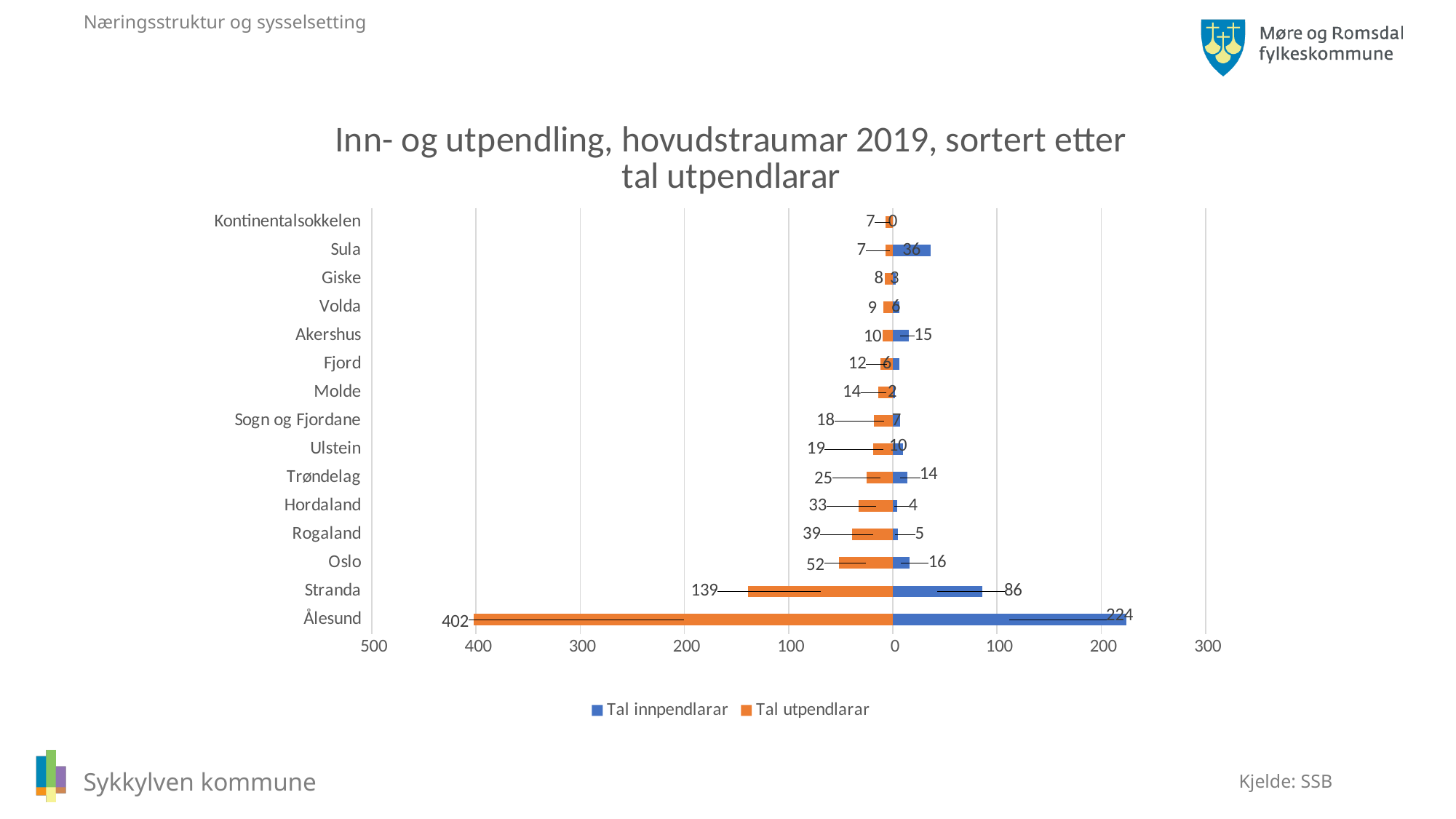
What is the value of Tal utpendlarar for Oslo? 52 What is the value of Tal innpendlarar for Sula? 36 Which category has the highest value of Tal utpendlarar? Ålesund What is the difference between Tal utpendlarar and Tal innpendlarar for Ålesund? 178 How many categories are shown on the vertical axis? 15 How many series does the legend list? 2 What is the title of the chart? Inn- og utpendling, hovudstraumar 2019, sortert etter tal utpendlarar Which category has the lowest value of Tal innpendlarar? Kontinentalsokkelen What is the value of Tal utpendlarar for Ålesund? 402 For Akershus, which is larger: Tal innpendlarar or Tal utpendlarar? Tal innpendlarar What kind of chart is shown on the slide? bar chart What is the value of Tal innpendlarar for Stranda? 86